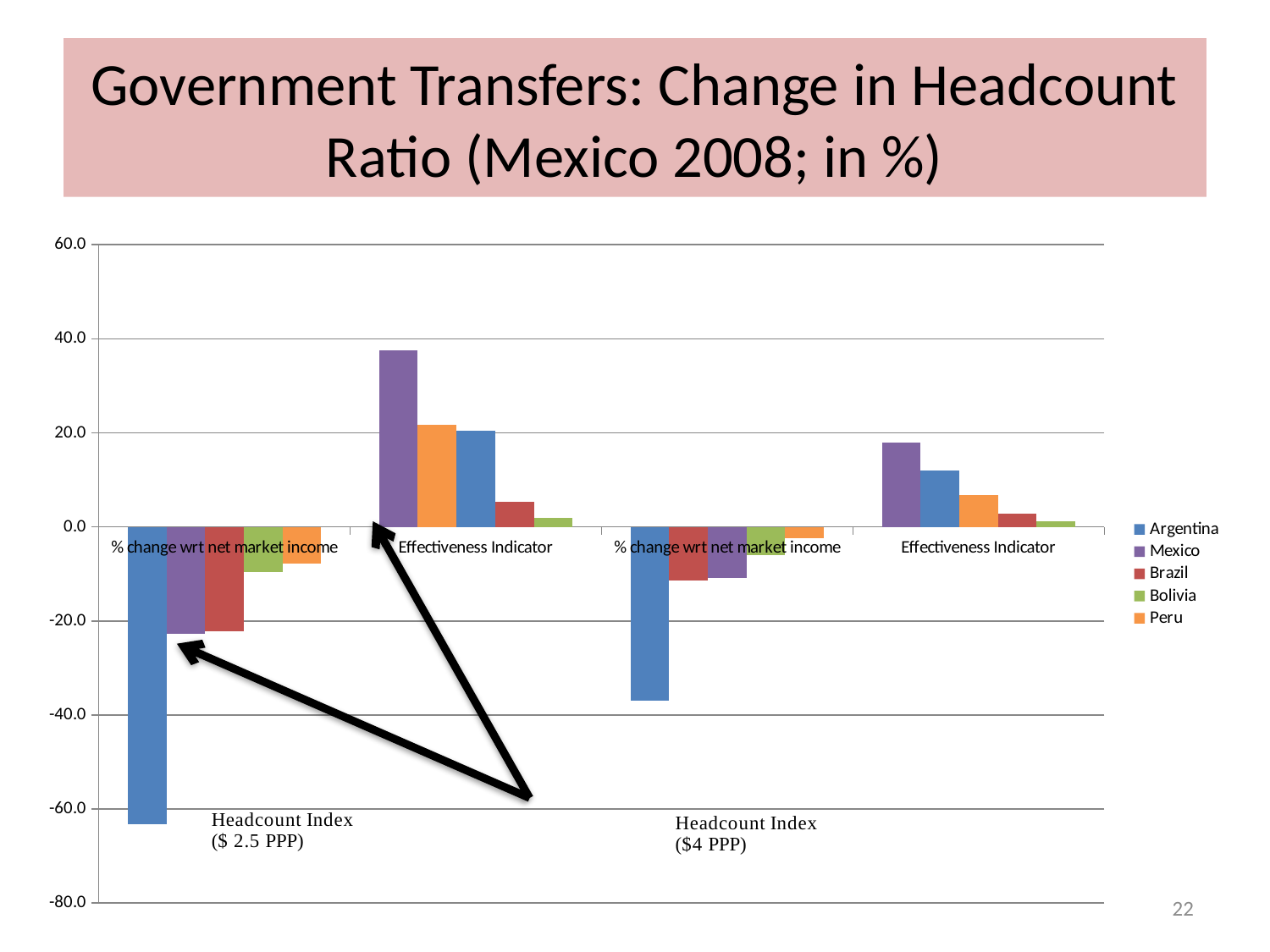
Is the value for Mexico in the Effectiveness Indicator group for the Headcount Index ($ 2.5 PPP) greater or less than 20.0? greater How many series does the legend list? 5 In the % change wrt net market income group for the Headcount Index ($ 2.5 PPP), which country has the lowest value? Argentina How many category groups are shown along the x axis? 4 What colour represents Argentina in the chart? Blue In the Effectiveness Indicator group for the Headcount Index ($4 PPP), which is larger, the value for Mexico or the value for Argentina? Mexico Is the value for Argentina in the % change wrt net market income group for the Headcount Index ($ 2.5 PPP) greater or less than -40.0? less In the Effectiveness Indicator group for the Headcount Index ($ 2.5 PPP), which country has the highest value? Mexico Is the value for Argentina in the % change wrt net market income group for the Headcount Index ($4 PPP) greater or less than -20.0? less In the % change wrt net market income group for the Headcount Index ($4 PPP), which is lower, the value for Argentina or the value for Mexico? Argentina What kind of chart is shown on the slide? Bar chart Which countries are listed in the legend? Argentina, Mexico, Brazil, Bolivia, Peru